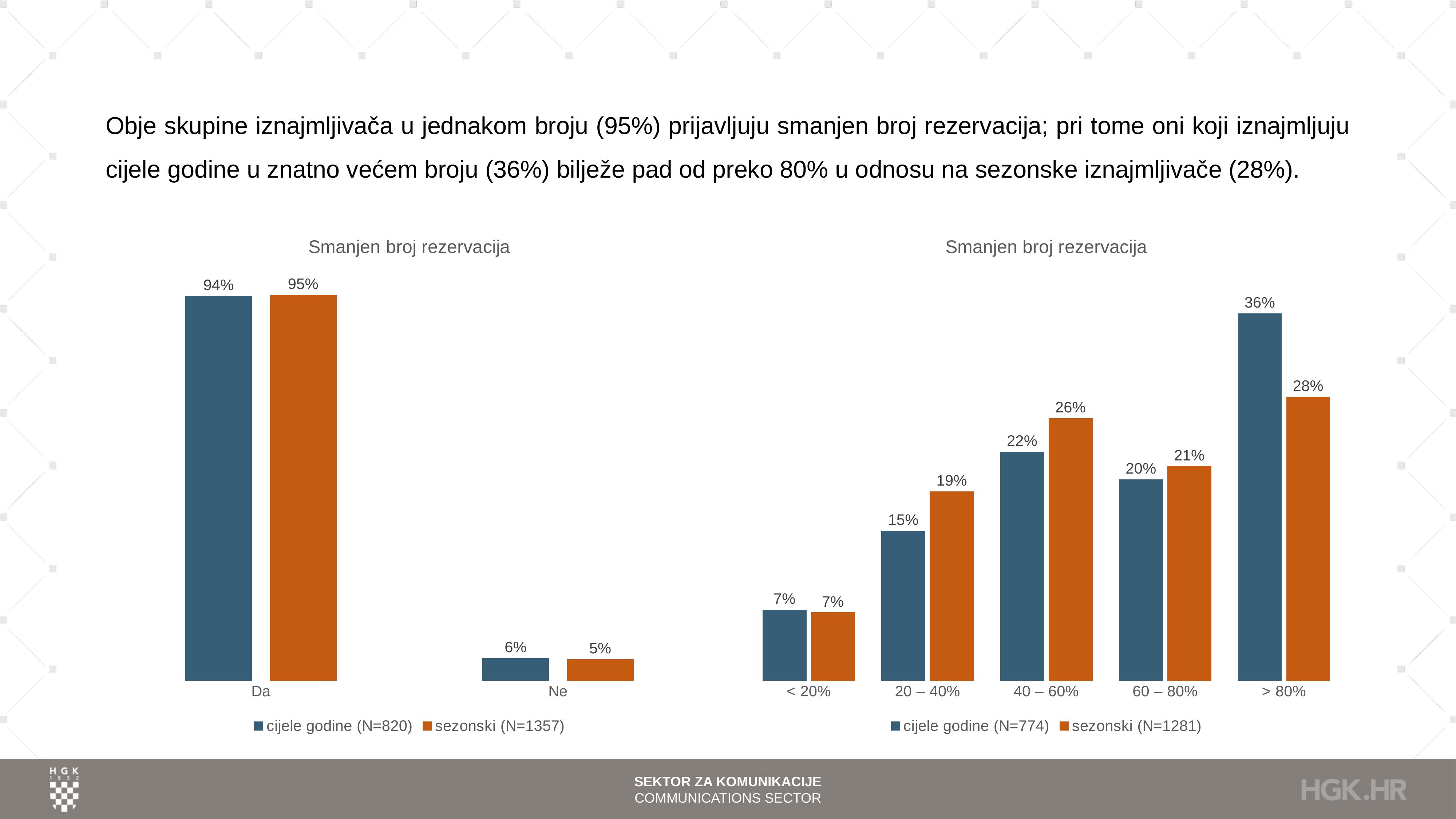
What type of chart is the left chart? Bar chart In the right chart, which category has the lowest value for 'cijele godine (N=774)'? < 20% How many series does the legend of the left chart list? 2 In the right chart, what is the difference between 'cijele godine (N=774)' and 'sezonski (N=1281)' in the '> 80%' category? 8% How many categories are shown on the x axis of the right chart? 5 In the left chart, what is the value for 'sezonski (N=1357)' in the 'Ne' category? 5% In the right chart, what is the value for 'cijele godine (N=774)' in the '> 80%' category? 36% In the right chart, what is the value for 'sezonski (N=1281)' in the '20 – 40%' category? 19% In the right chart, which series has the larger value in the '40 – 60%' category? sezonski (N=1281) In the left chart, what is the value for 'cijele godine (N=820)' in the 'Da' category? 94% In the right chart, which category has the highest value for 'sezonski (N=1281)'? > 80% What is the title of the right chart? Smanjen broj rezervacija